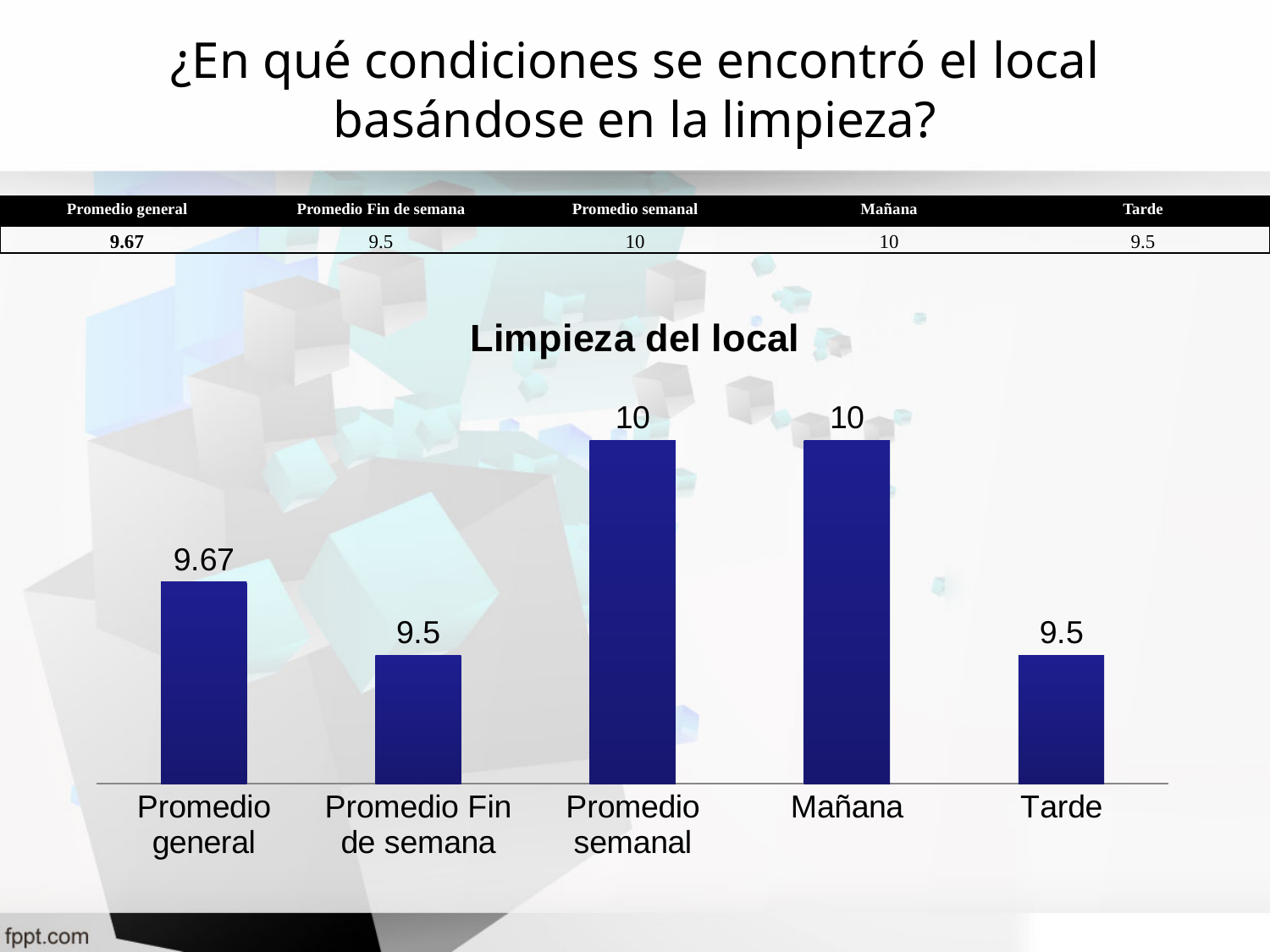
Which category has the lowest value in the Limpieza del local chart? Promedio Fin de semana and Tarde (both 9.5) What is the difference between the values for Promedio general and Tarde? 0.17 What is the value for Promedio general in the Limpieza del local chart? 9.67 What kind of chart is shown on the slide? Bar chart What is the difference between the values for Promedio semanal and Promedio Fin de semana? 0.5 Which is larger, the value for Promedio general or the value for Tarde? Promedio general What is the title of the chart on the slide? Limpieza del local What is the value for Promedio Fin de semana in the Limpieza del local chart? 9.5 Which is larger, the value for Mañana or the value for Promedio Fin de semana? Mañana How many categories are shown in the Limpieza del local chart? 5 What is the value for Tarde in the Limpieza del local chart? 9.5 What is the value for Mañana in the Limpieza del local chart? 10